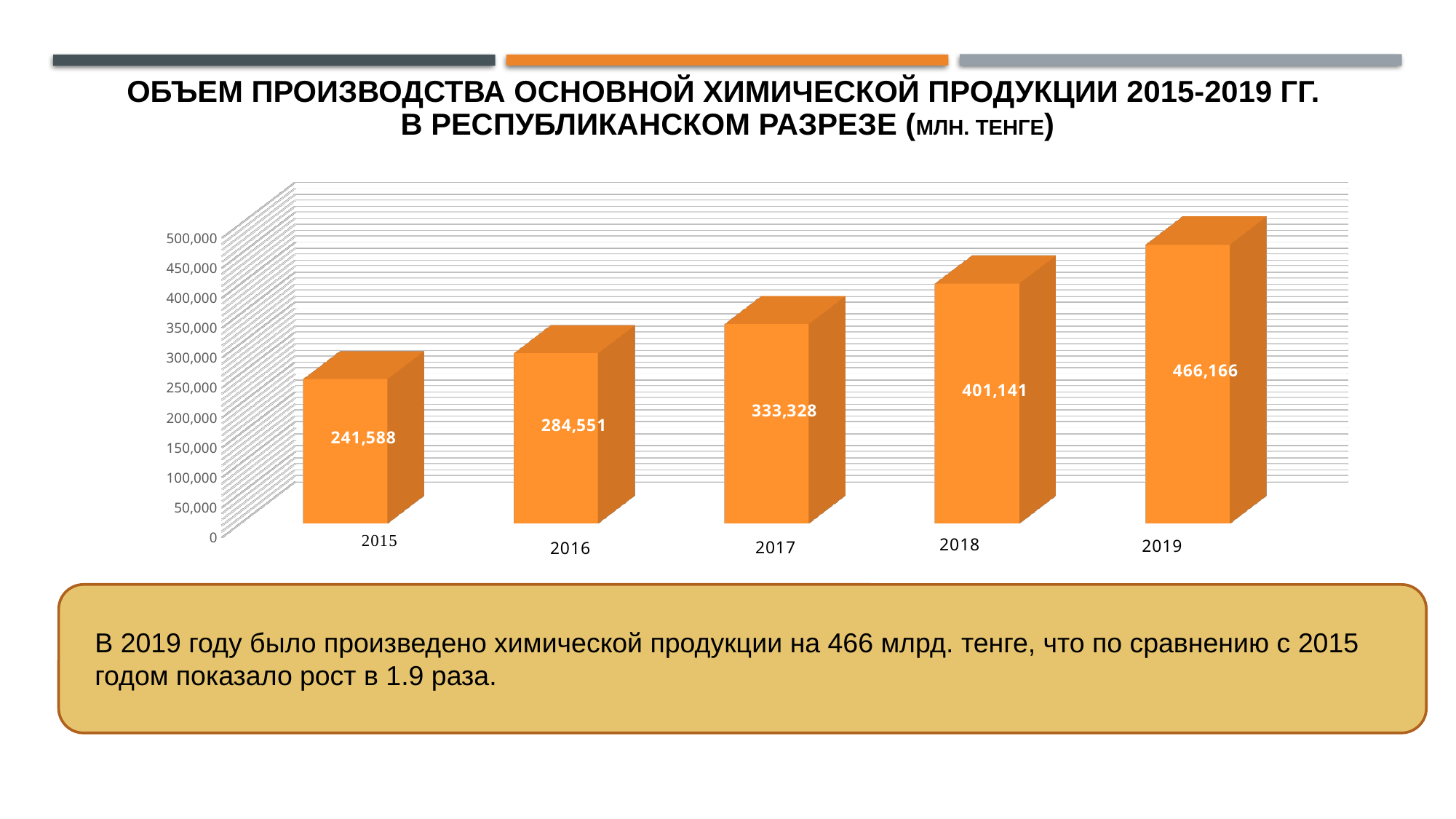
What is the value for 2015? 241,588 How many years are shown on the chart? 5 What kind of chart is shown on the slide? bar chart What is the value for 2019? 466,166 What is the difference between the values for 2019 and 2015? 224,578 Is the value for 2018 greater or less than 400,000? greater Do the values rise or fall from 2015 to 2019? rise Which is larger, the value for 2016 or the value for 2018? 2018 Which year has the highest value? 2019 What is the difference between the values for 2018 and 2017? 67,813 What is the value for 2017? 333,328 Which year has the lowest value? 2015